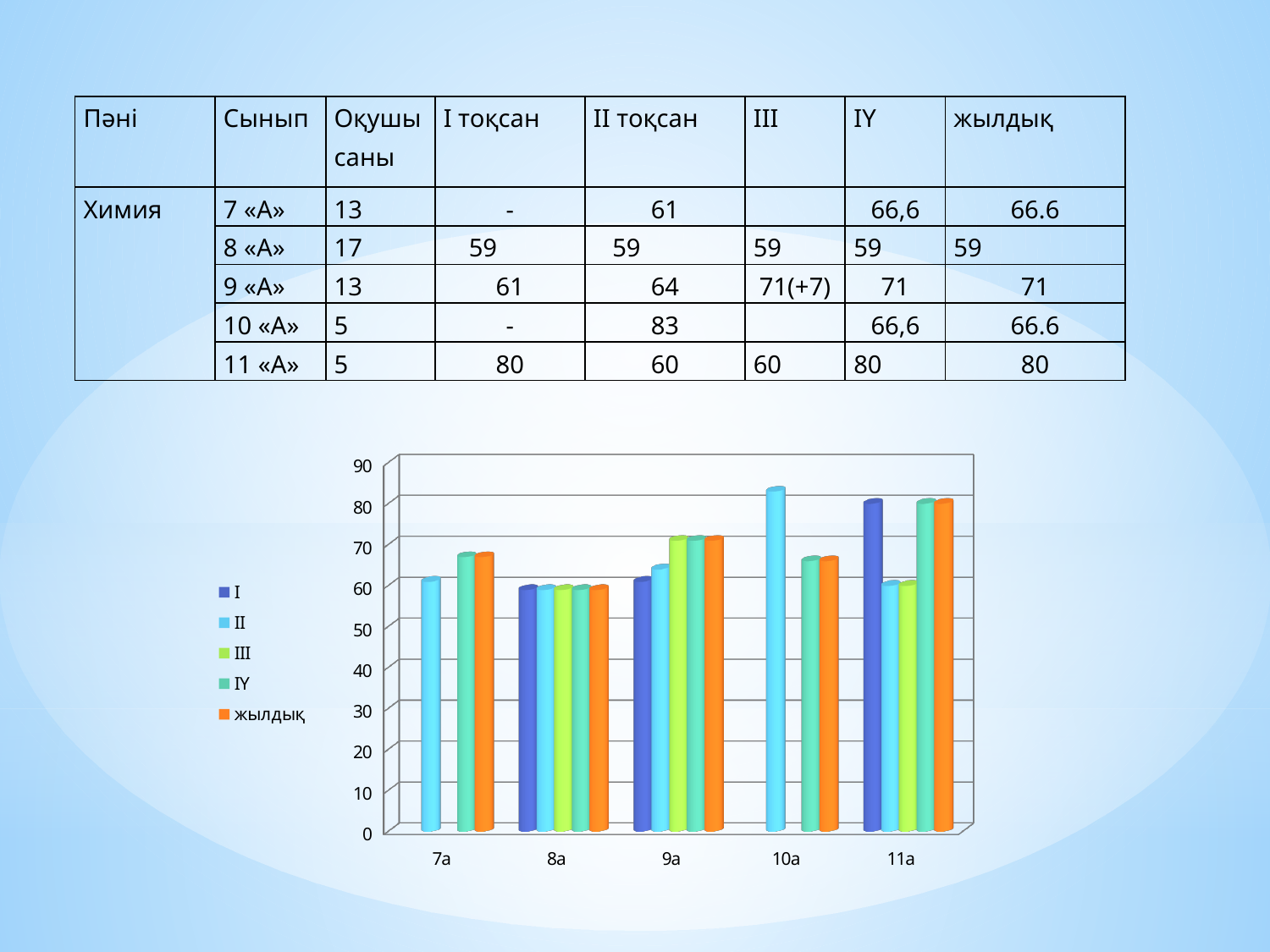
How many categories are shown on the x axis of the chart? 5 Which is larger: series III for 9a or series III for 8a? 9a What kind of chart is shown on the slide? bar chart Is the value of series II for 10a greater or less than 80? greater Which category has the highest bar for series II? 10a How many bars are shown for category 7a? 3 Is the value of series II for 7a greater or less than 70? less Which is larger for 11a: series I or series II? series I How many series does the chart legend list? 5 What are the entries listed in the chart legend? I, II, III, IY, жылдық What is the value of series I for 11a? 80 Which category has the lowest bar for the жылдық series? 8a